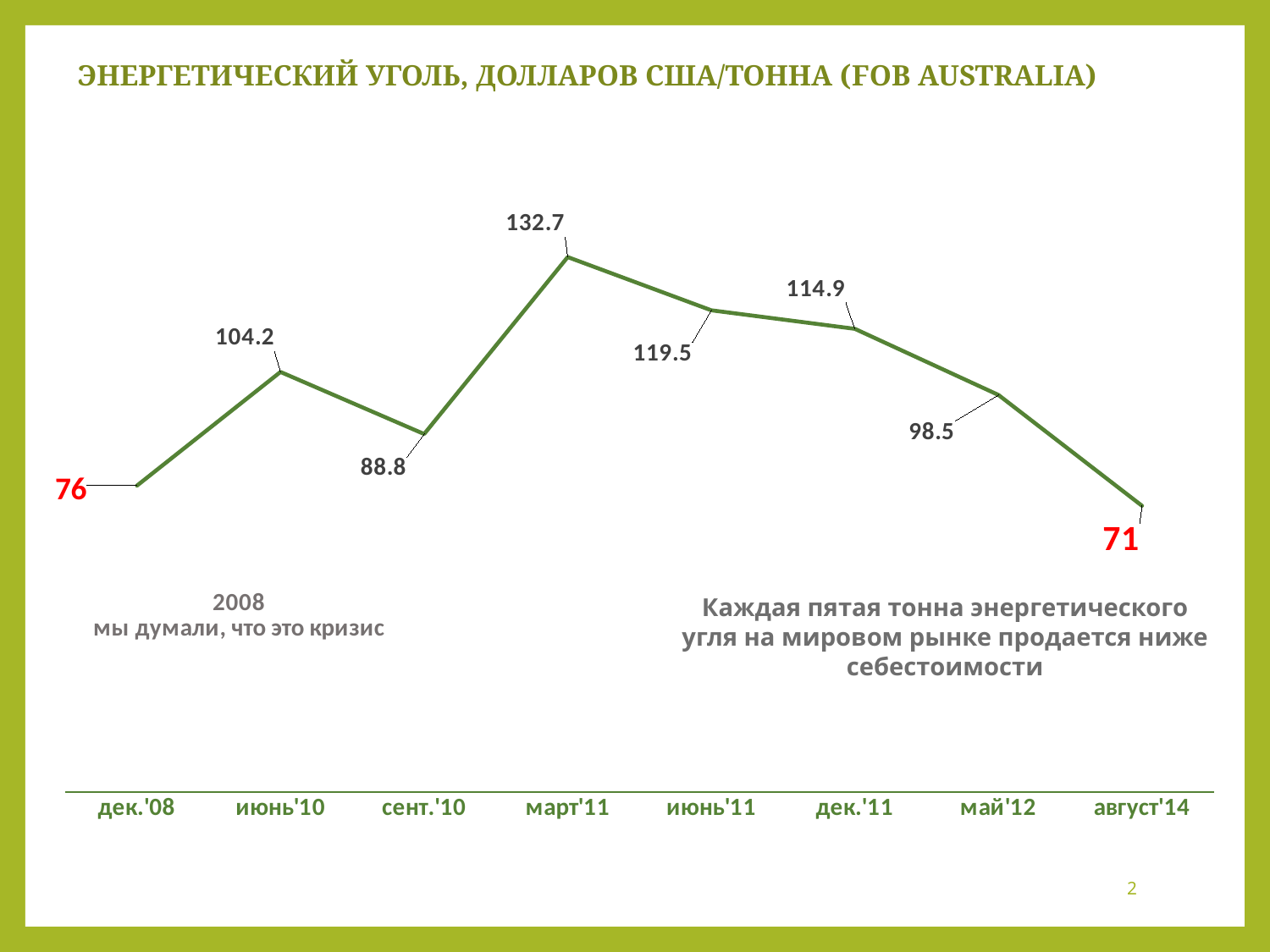
What is the difference between the values for июнь'10 and сент.'10? 15.4 Which point on the x axis has the highest value? март'11 What is the difference between the values for март'11 and август'14? 61.7 What is the value for май'12? 98.5 What is the value for март'11? 132.7 Which is larger, the value for июнь'11 or the value for дек.'11? июнь'11 What is the value for август'14? 71 What is the value for дек.'08? 76 How many data points are plotted on the chart? 8 Which point on the x axis has the lowest value? август'14 Do the values rise or fall from март'11 to август'14? fall What kind of chart is shown on the slide? line chart